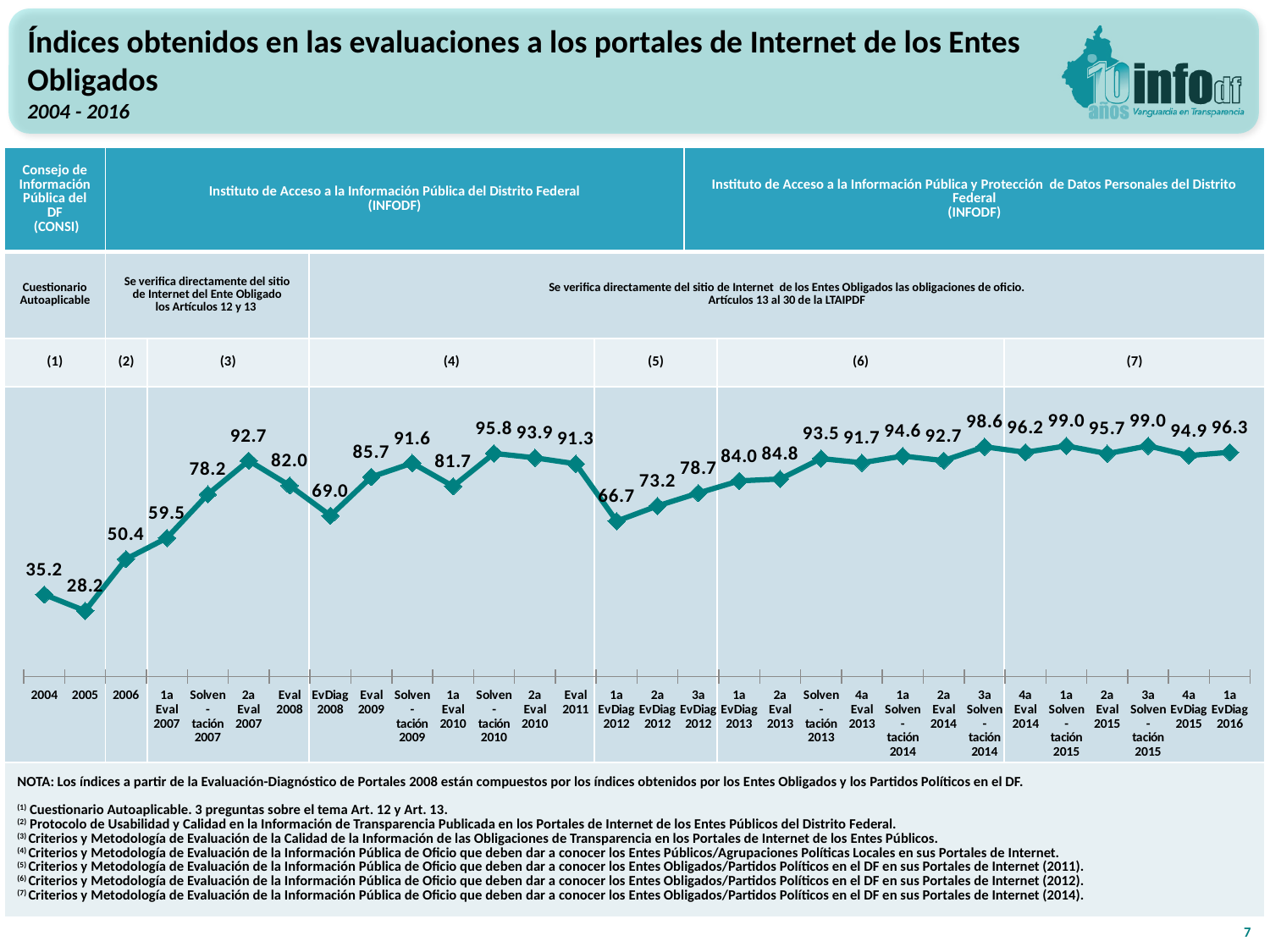
What is the index value for 1a EvDiag 2016? 96.3 How many data points are plotted on the chart? 30 What is the index value for 2a Eval 2007? 92.7 Do the index values rise or fall from 1a EvDiag 2012 to 3a EvDiag 2012? rise Which evaluation has the lowest index value? 2005 What is the index value for 1a EvDiag 2012? 66.7 What type of chart is shown on the slide? line chart What is the index value for 2004? 35.2 What is the difference between the index values for 3a Solventación 2014 and 4a Eval 2014? 2.4 Which is larger, the index value for Eval 2008 or for EvDiag 2008? Eval 2008 What is the highest index value shown on the chart? 99.0 What is the difference between the index values for 2006 and 2005? 22.2